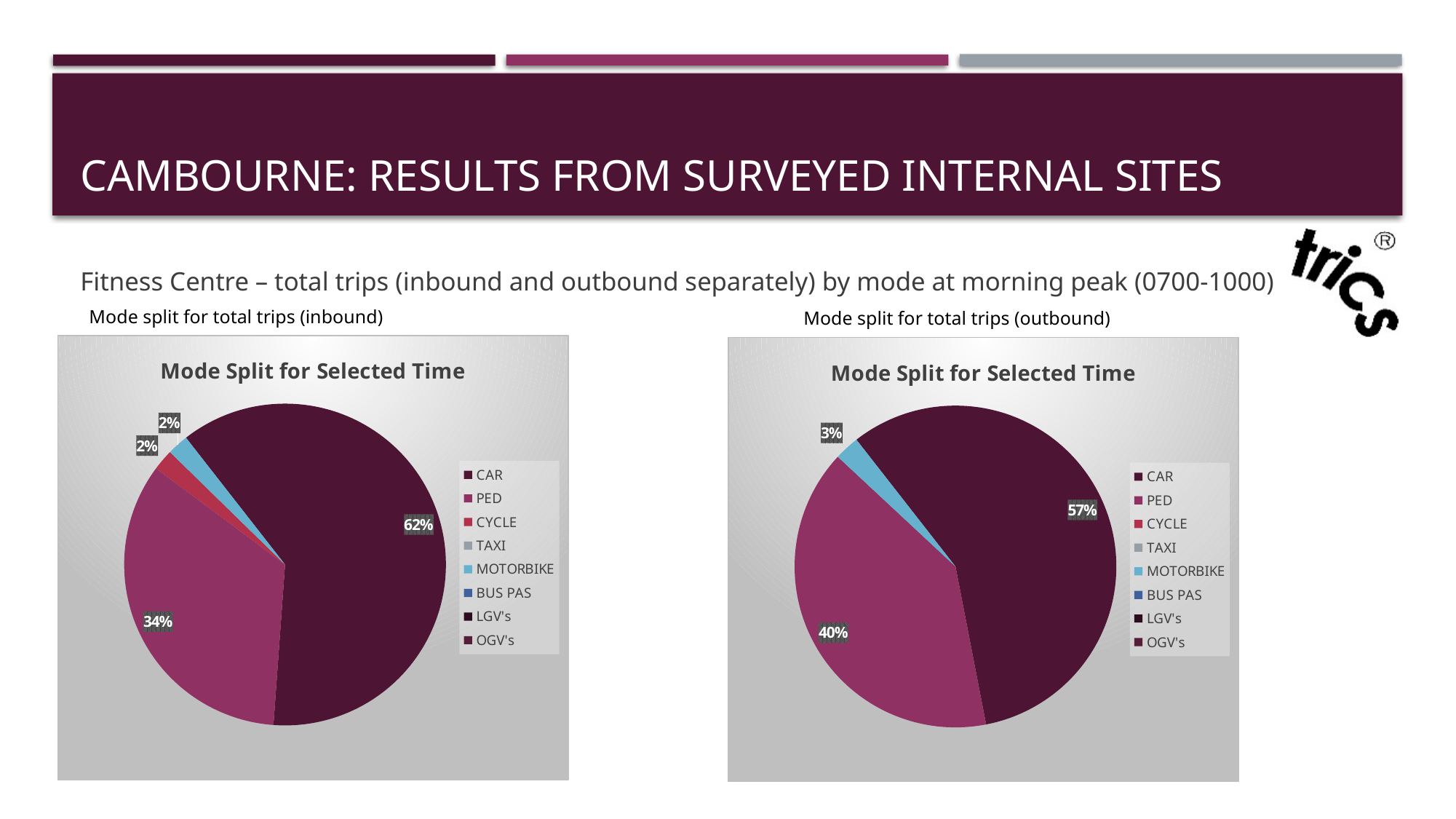
In the outbound chart, what share of total trips is by MOTORBIKE? 3% Is the CAR share larger in the inbound chart or the outbound chart? inbound In the inbound chart, which mode has the largest share of trips? CAR In the outbound chart, which mode has the largest share of trips? CAR How many modes are listed in the legend of the outbound chart? 8 In the outbound chart, what share of total trips is by PED? 40% In the inbound chart, what share of total trips is by CAR? 62% What type of chart is used for the inbound mode split? pie chart In the inbound chart, what is the difference between the CAR share and the PED share? 28% In the outbound chart, what is the difference between the CAR share and the PED share? 17% In the outbound chart, what share of total trips is by CAR? 57% In the inbound chart, what share of total trips is by PED? 34%